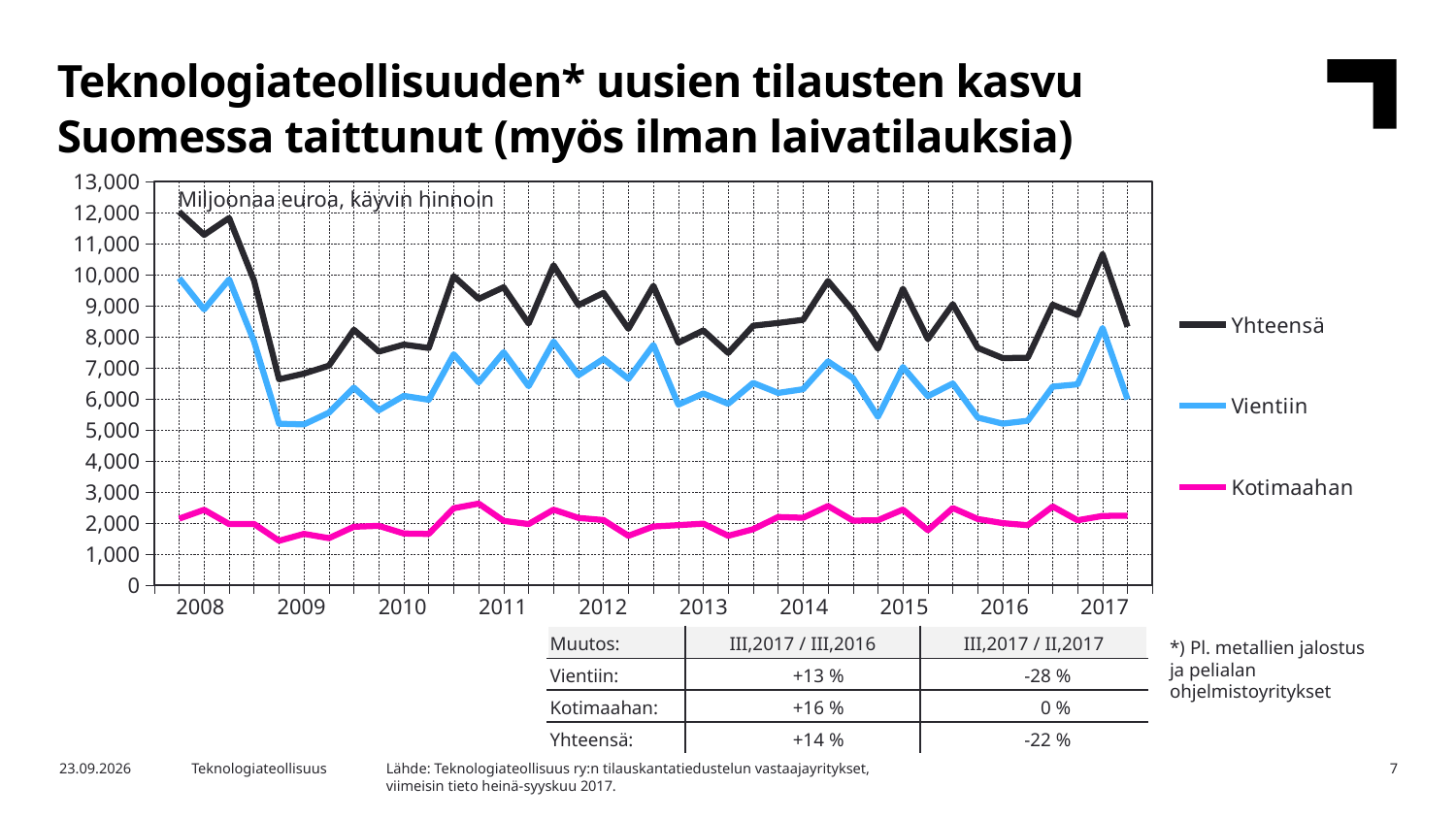
Is the value for Kotimaahan at the start of 2008 greater or less than 3,000? less Is the value for Yhteensä at the start of 2009 greater or less than 8,000? less Is the value for Vientiin at the start of 2009 greater or less than 6,000? less What kind of chart is shown on the slide? line chart Does the Yhteensä line rise or fall from the start of 2008 to the start of 2009? fall Which series has the lowest values throughout the whole period? Kotimaahan How many series does the legend list? 3 Which series is shown in black in the legend? Yhteensä How many years are labelled on the x axis? 10 Which series is higher in 2012, Vientiin or Kotimaahan? Vientiin What unit is stated in the text inside the chart area? Miljoonaa euroa, käyvin hinnoin